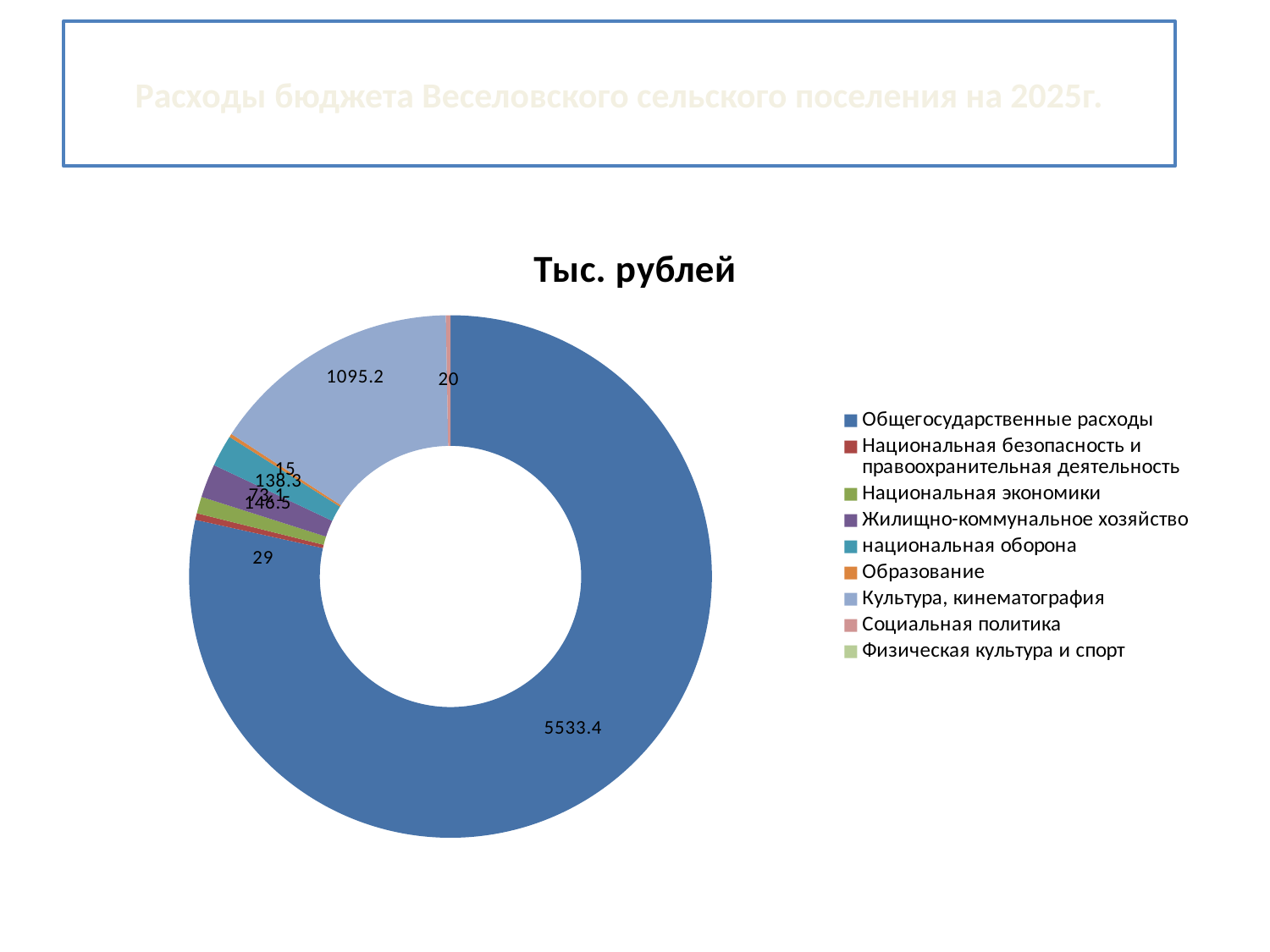
What is the value for Социальная политика? 20 How many categories does the legend list? 9 What is the difference between Общегосударственные расходы and Культура, кинематография? 4438.2 What is the chart's title? Тыс. рублей What is the value for Общегосударственные расходы? 5533.4 What is the value for Культура, кинематография? 1095.2 Which is larger: Культура, кинематография or Национальная безопасность и правоохранительная деятельность? Культура, кинематография Which category has the largest slice? Общегосударственные расходы What is the value for Национальная безопасность и правоохранительная деятельность? 29 What kind of chart is shown on the slide? doughnut (pie) chart What is the difference between Национальная безопасность и правоохранительная деятельность and Социальная политика? 9 What is the value for Образование? 15